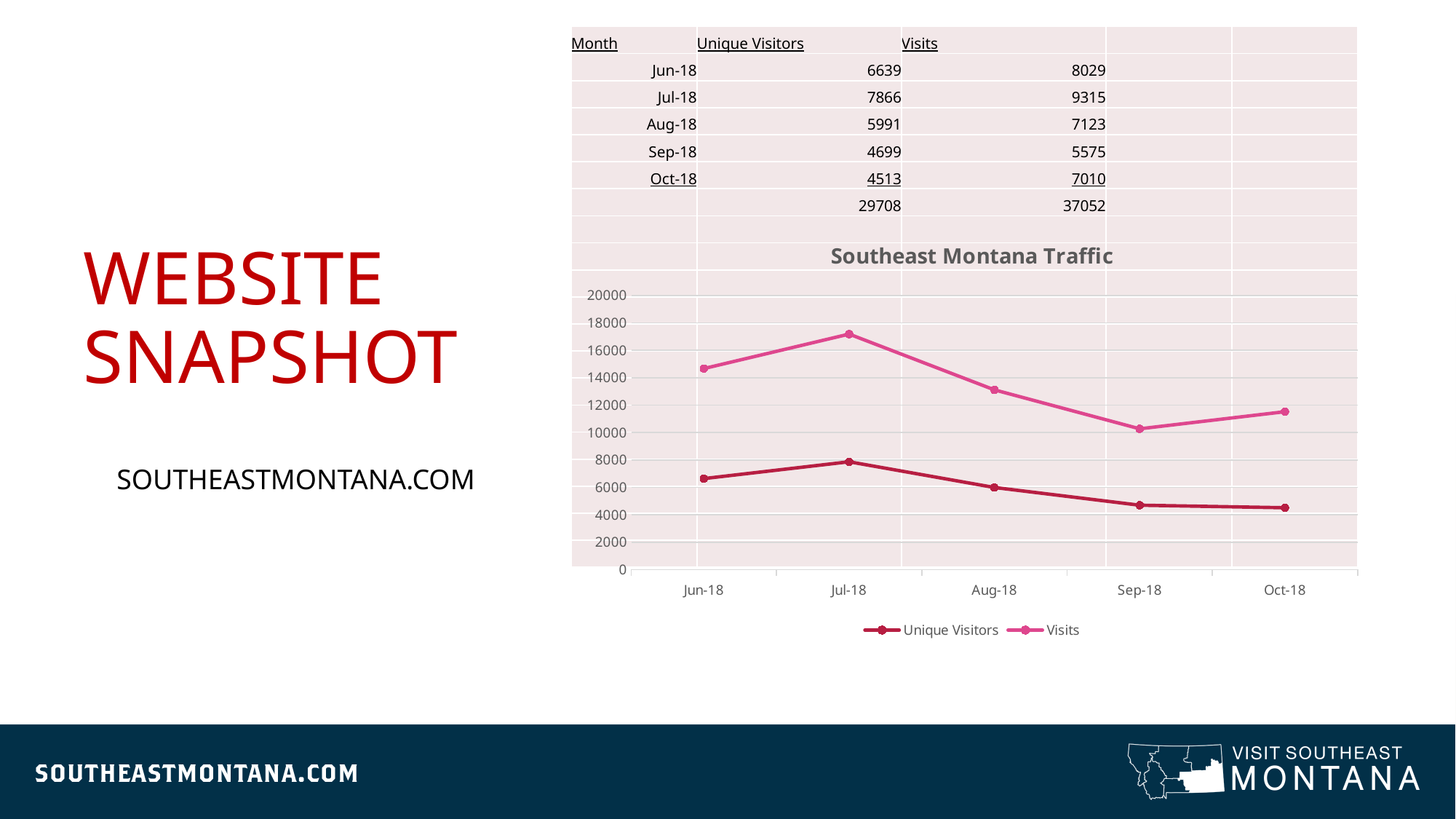
What is the title of the line chart on the slide? Southeast Montana Traffic In the Southeast Montana Traffic chart, which month has the highest Unique Visitors value? Jul-18 According to the table above the chart, what is the Unique Visitors value for Sep-18? 4699 In the Southeast Montana Traffic chart, is the plotted Visits line value for Sep-18 greater or less than 12000? less In the Southeast Montana Traffic chart, do the Unique Visitors values rise or fall from Jul-18 to Oct-18? fall How many series does the legend of the Southeast Montana Traffic chart list? 2 According to the table above the chart, what is the Unique Visitors value for Jul-18? 7866 How many months are plotted along the x axis of the Southeast Montana Traffic chart? 5 In the Southeast Montana Traffic chart, is the plotted Visits line value for Jul-18 greater or less than 16000? greater What kind of chart is shown under the title "Southeast Montana Traffic"? line chart In the Southeast Montana Traffic chart, which month has the lowest Unique Visitors value? Oct-18 Using the table values, what is the difference in Unique Visitors between Jul-18 and Jun-18? 1227